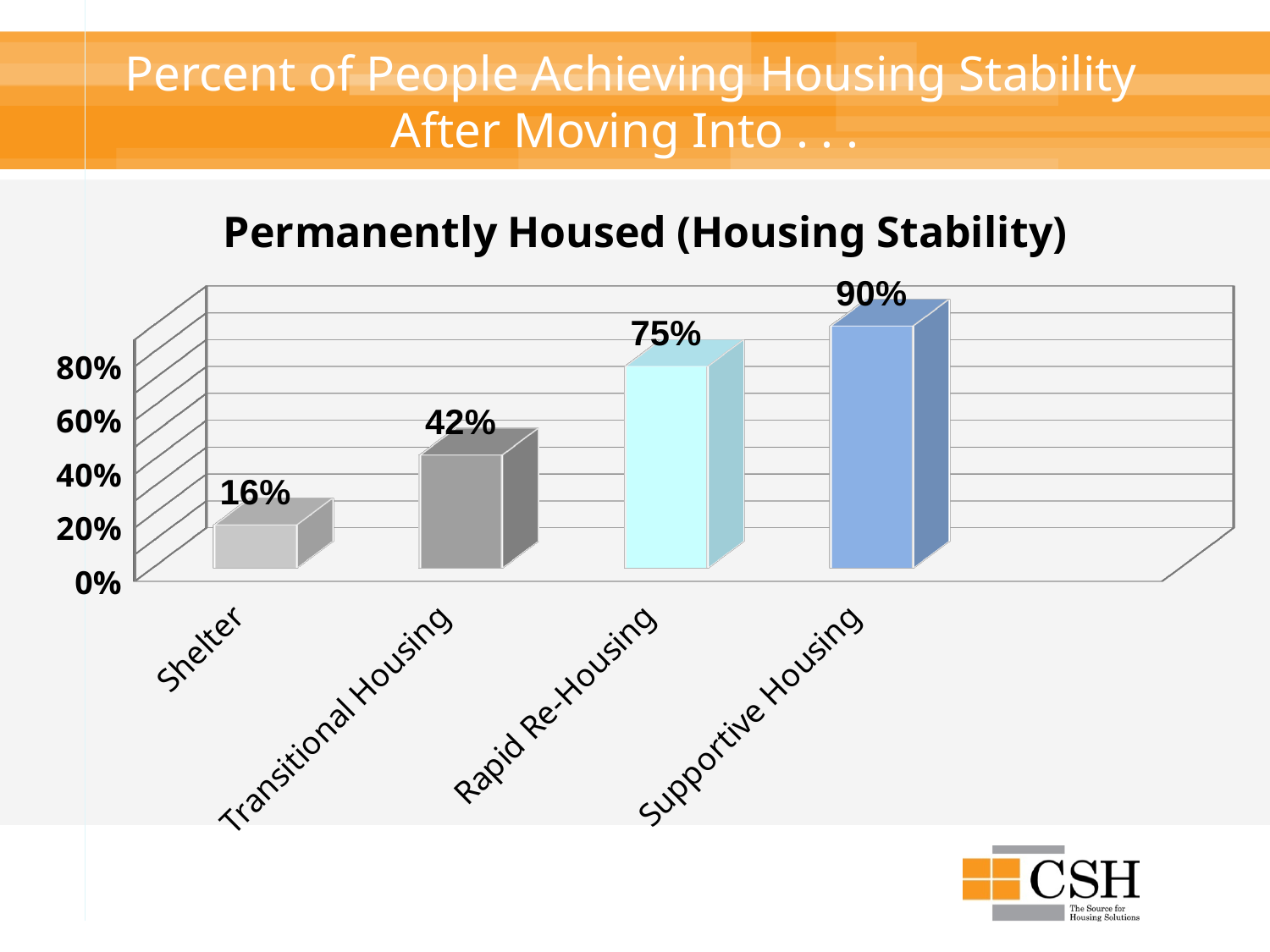
How many categories are shown in the chart? 4 What is the value for Rapid Re-Housing? 75% What is the value for Shelter? 16% What kind of chart is shown on the slide? Bar chart What is the difference between the values for Supportive Housing and Shelter? 74% Which is larger, the value for Transitional Housing or the value for Rapid Re-Housing? Rapid Re-Housing What is the difference between the values for Rapid Re-Housing and Transitional Housing? 33% Which category has the lowest value? Shelter Which category has the highest value? Supportive Housing Do the values rise or fall from left to right along the x axis? Rise What is the value for Transitional Housing? 42% What is the value for Supportive Housing? 90%